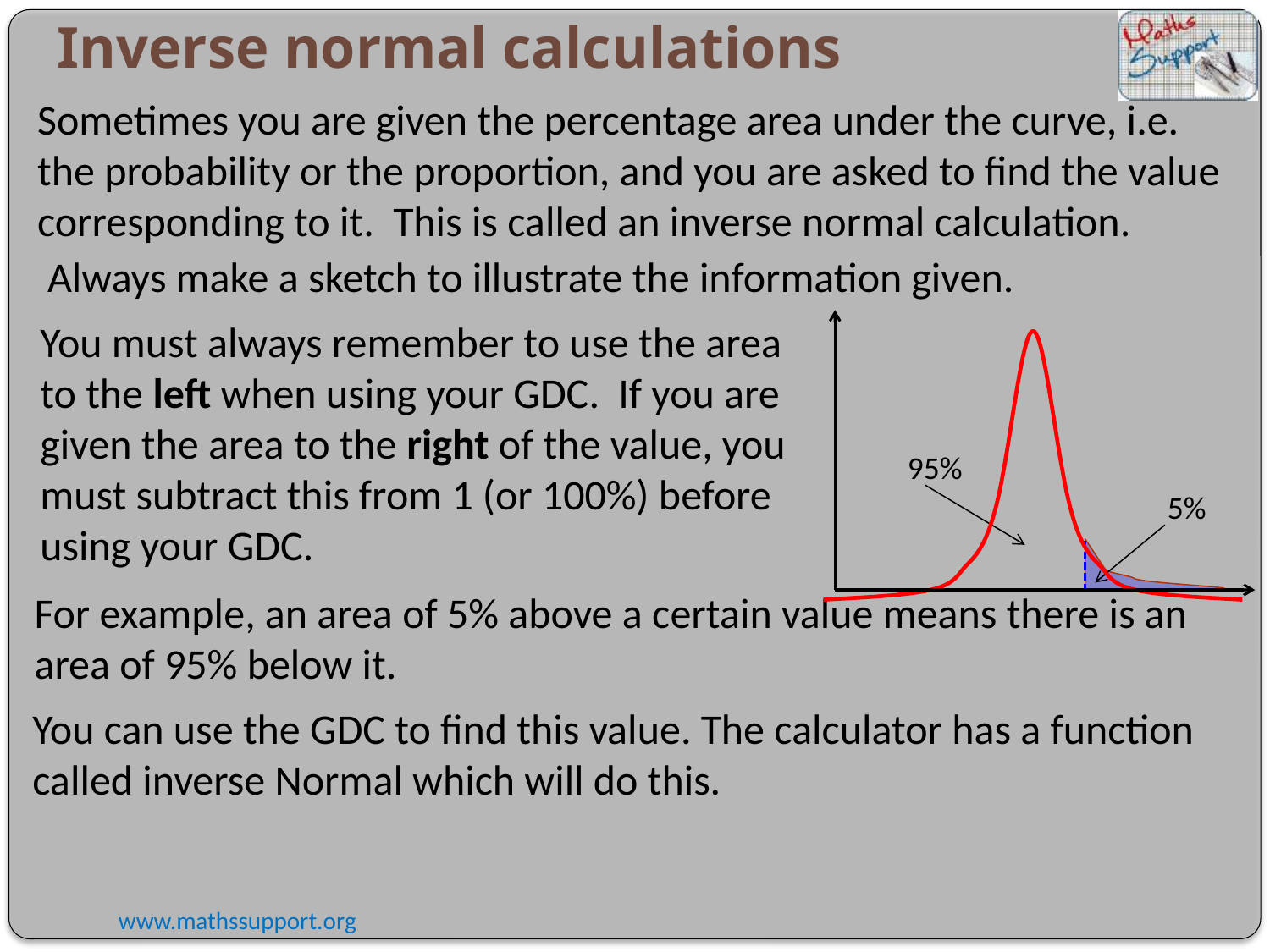
On the sketch of the normal curve, what is the difference between the two labelled percentages? 90% On the sketch of the normal curve, what percentage is labelled for the shaded area to the right of the dashed line? 5% How many percentage labels are shown on the sketch of the normal curve? 2 On the sketch of the normal curve, which labelled region has the smallest percentage? the shaded tail on the right (5%) On the sketch of the normal curve, what do the two labelled percentages add up to? 100% On the sketch of the normal curve, what percentage is labelled for the area to the left of the dashed line? 95% On the sketch of the normal curve, which labelled area is larger, the one to the left of the dashed line or the one to the right? the one to the left (95%) What style of line marks the cut-off value on the sketch of the normal curve? a blue dashed line What colour is the curve drawn on the sketch? red